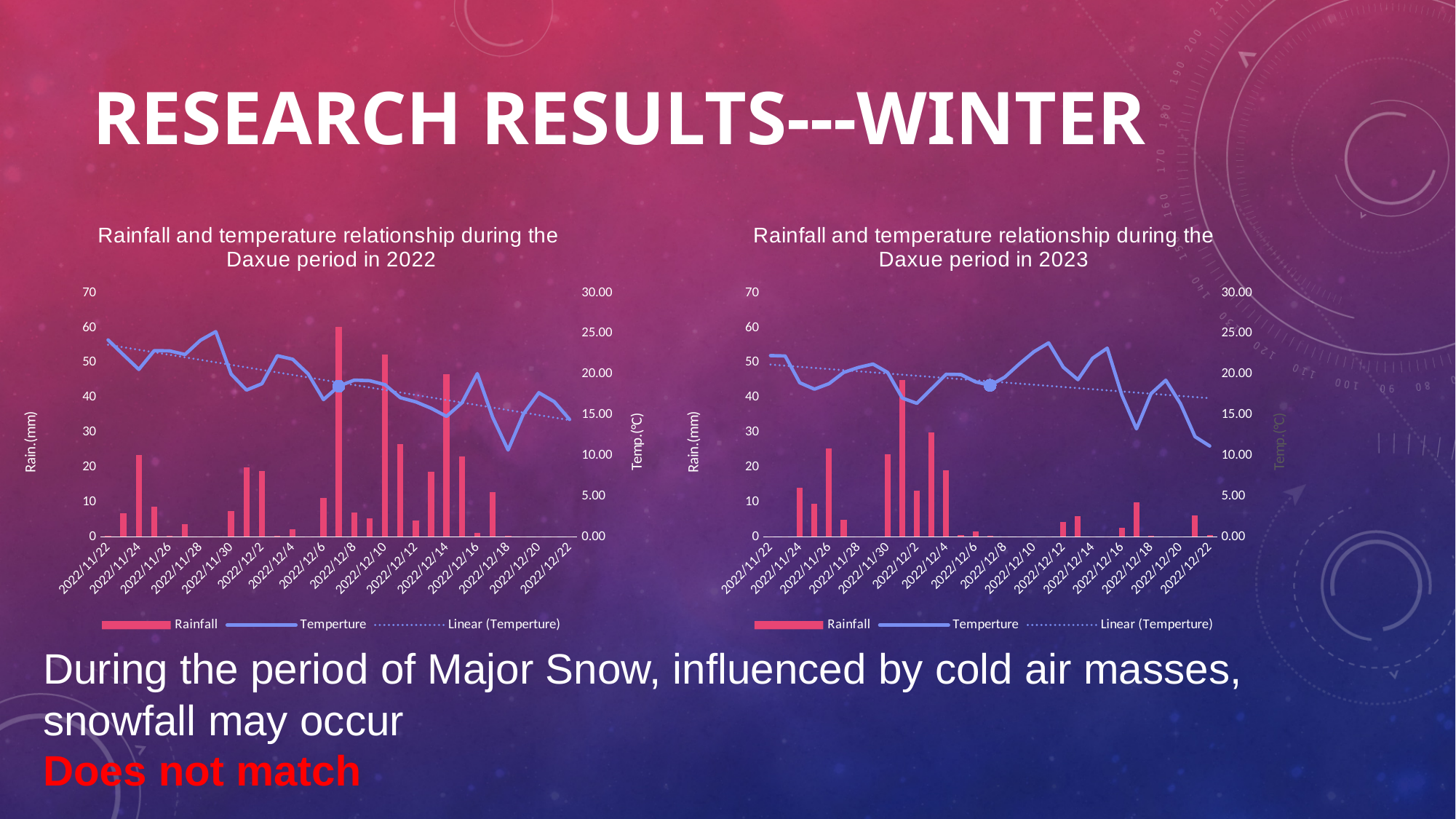
In the 2022 chart, is the tallest Rainfall bar greater or less than 50 mm? greater In the 2022 chart, is the Temperture value at 2022/11/22 greater or less than 20.00? greater What is the title of the left chart? Rainfall and temperature relationship during the Daxue period in 2022 In the 2022 chart, does the Linear (Temperture) trend line rise or fall across the period? Fall Which chart has the taller maximum Rainfall bar, the 2022 chart or the 2023 chart? The 2022 chart In the 2023 chart, is the Temperture value at 2022/12/22 greater or less than 15.00? less What kind of chart is the 'Rainfall and temperature relationship during the Daxue period in 2022' chart? A combined bar and line chart In the 2023 chart, does the Temperture line generally rise or fall from 2022/11/22 to 2022/12/22? Fall How many series does the legend list in the 'Rainfall and temperature relationship during the Daxue period in 2023' chart? 3 What are the three legend entries in the 2022 chart? Rainfall, Temperture, Linear (Temperture)